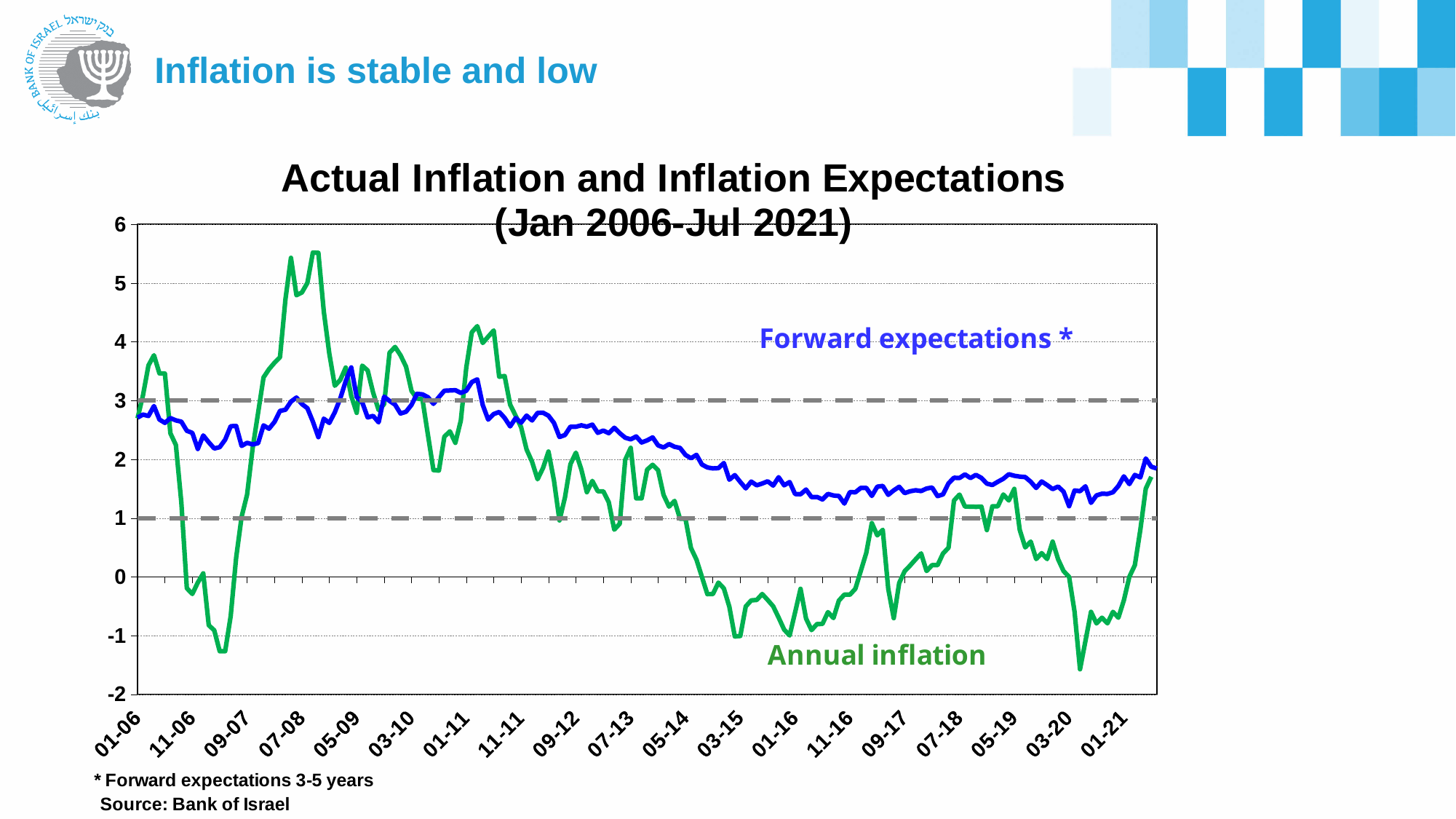
What is the title of the chart? Actual Inflation and Inflation Expectations (Jan 2006-Jul 2021) Which series reaches the highest value anywhere on the chart? Annual inflation At what values are the two horizontal dashed gray lines drawn? 1 and 3 Is the value of Forward expectations at 01-16 greater or less than 2? less Which series reaches the lowest value anywhere on the chart? Annual inflation Is the peak value of Annual inflation around 07-08 greater or less than 5? greater What kind of chart is shown on the slide? Line chart At 03-15, which is higher: Forward expectations or Annual inflation? Forward expectations Does Forward expectations rise or fall between 01-11 and 01-16? Fall How many data series are plotted in the chart? 4 Is the value of Annual inflation at 03-15 greater or less than 0? less